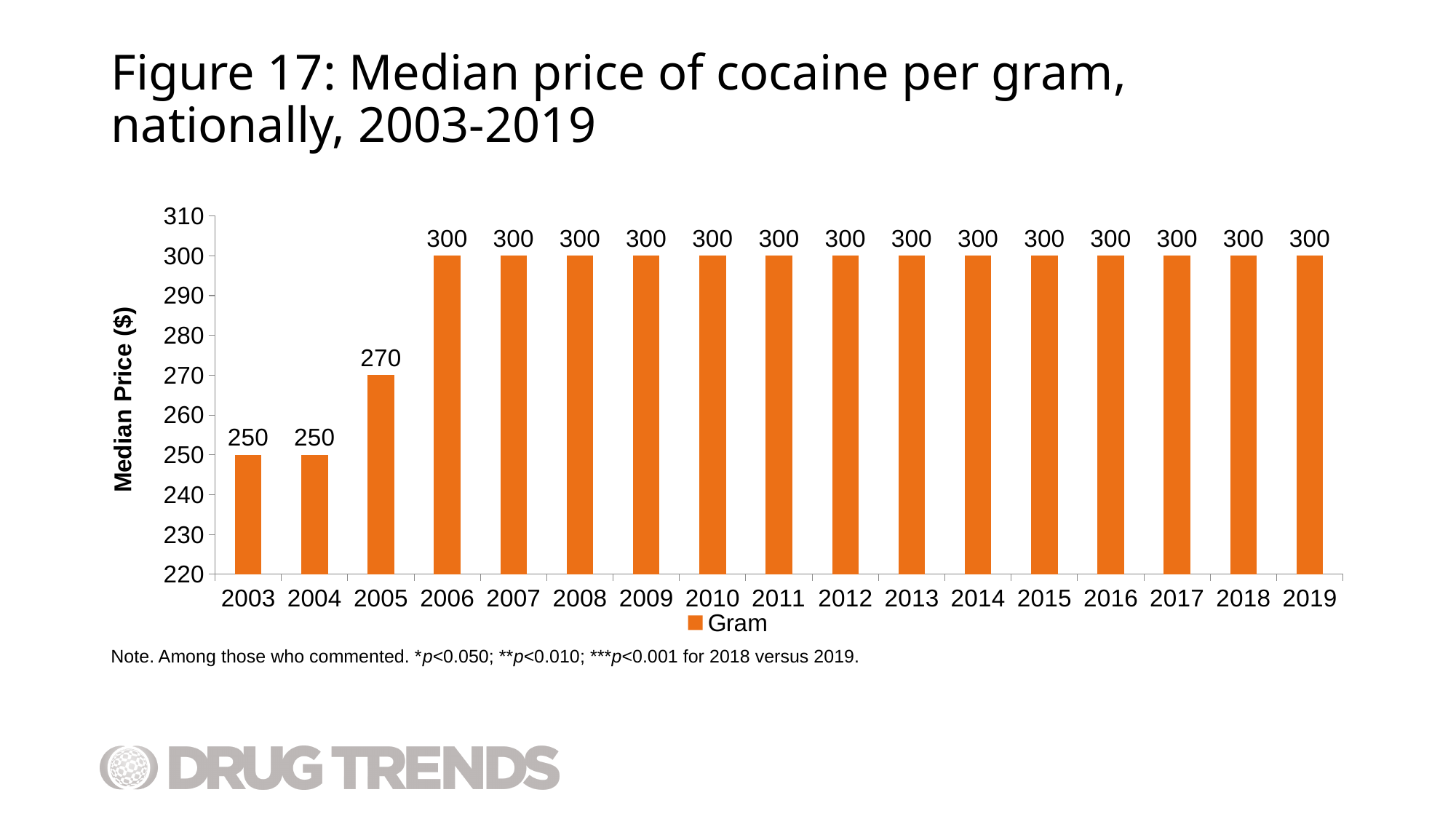
What is the median price of cocaine per gram in 2019? 300 How many years are shown on the x axis? 17 What is the difference between the median price in 2005 and in 2004? 20 Is the median price in 2005 greater or less than 260? greater How many series does the legend list? 1 Which year has the lowest median price, 2004 or 2005? 2004 What is the label of the y axis? Median Price ($) Does the median price rise or fall from 2003 to 2006? rise What is the median price of cocaine per gram in 2003? 250 What is the median price of cocaine per gram in 2005? 270 What kind of chart is shown on the slide? bar chart What is the difference between the median price in 2006 and in 2003? 50